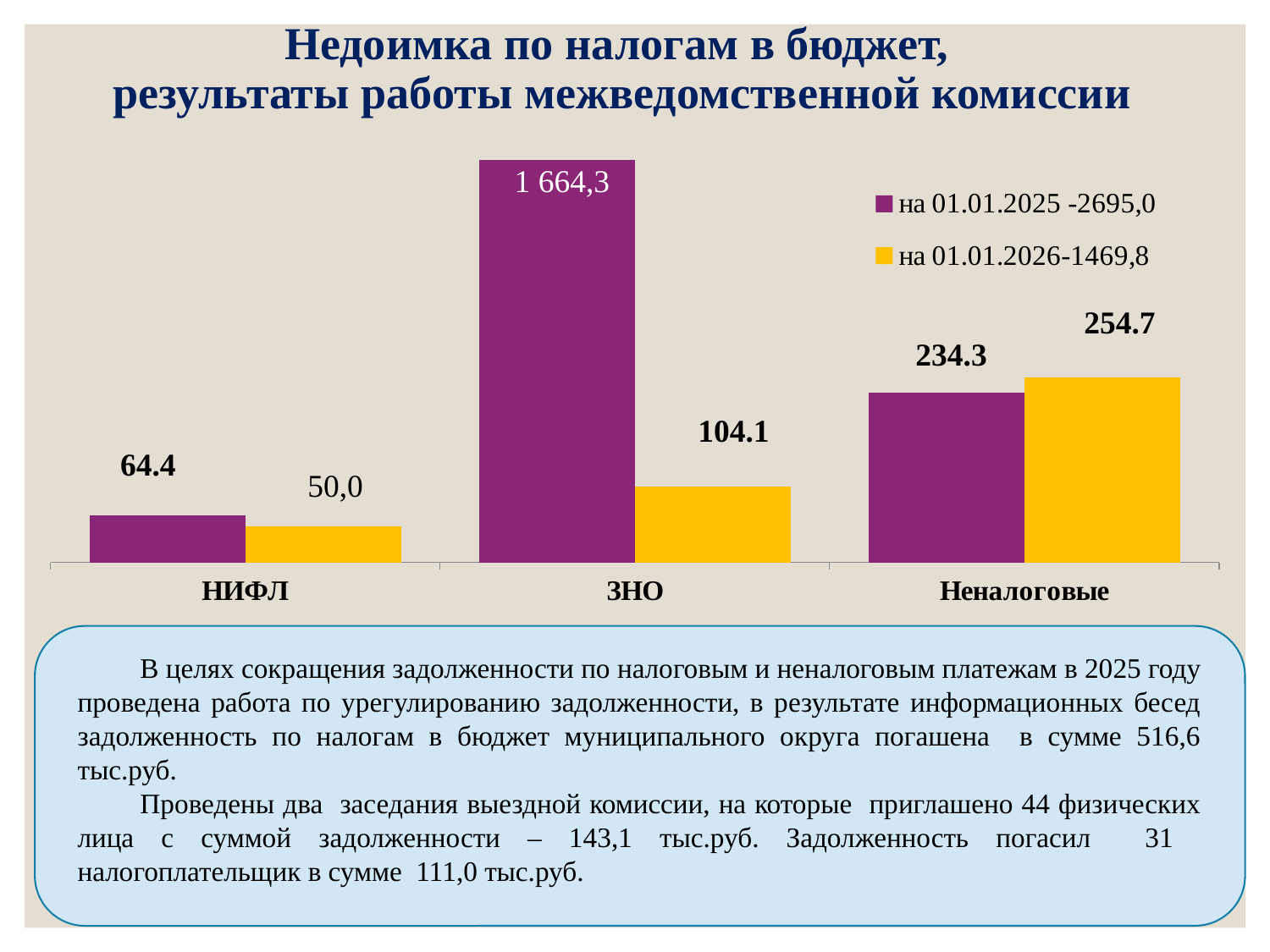
Which category has the lowest value in the series 'на 01.01.2026-1469,8'? НИФЛ Which category has the highest value in the series 'на 01.01.2025 -2695,0'? ЗНО For Неналоговые, which series has the larger value: 'на 01.01.2025 -2695,0' or 'на 01.01.2026-1469,8'? на 01.01.2026-1469,8 What is the value for НИФЛ in the series 'на 01.01.2026-1469,8'? 50,0 What is the difference between the two series values for Неналоговые? 20.4 What kind of chart is shown on the slide? Bar chart What is the value for ЗНО in the series 'на 01.01.2026-1469,8'? 104.1 How many categories are shown on the x axis? 3 What is the value for ЗНО in the series 'на 01.01.2025 -2695,0'? 1 664,3 How many series does the legend list? 2 What is the difference between the two series values for НИФЛ? 14.4 What is the value for Неналоговые in the series 'на 01.01.2025 -2695,0'? 234.3